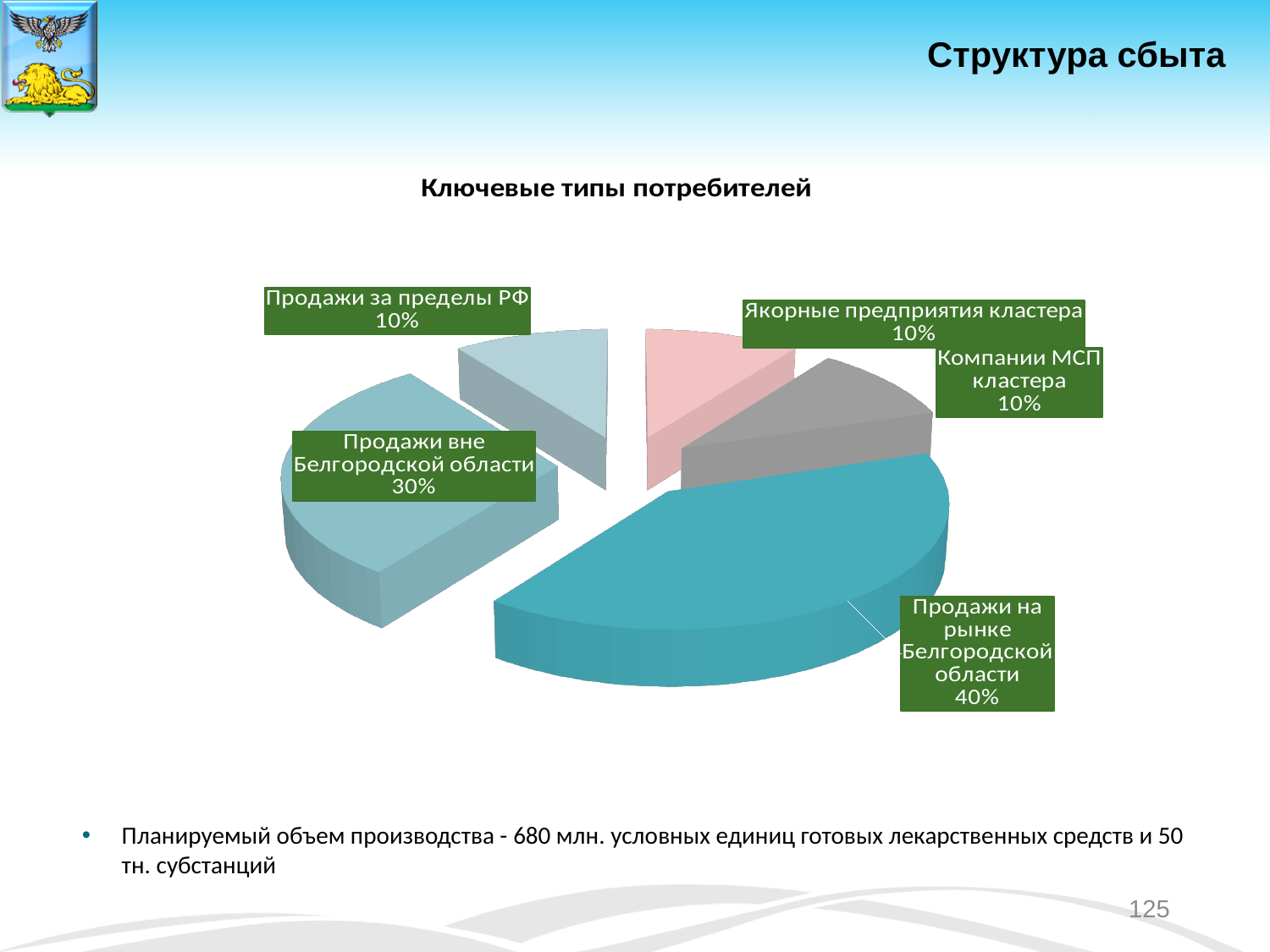
How many categories share the same value of 10%? 3 Which is larger: the share for "Продажи вне Белгородской области" or the share for "Продажи за пределы РФ"? Продажи вне Белгородской области What share of the pie does "Продажи за пределы РФ" represent? 10% What is the difference in percentage points between "Продажи на рынке Белгородской области" and "Продажи вне Белгородской области"? 10 percentage points What share of the pie does "Продажи на рынке Белгородской области" represent? 40% How many slices does the pie chart have? 5 Which category has the largest slice of the pie? Продажи на рынке Белгородской области What share of the pie does "Продажи вне Белгородской области" represent? 30% What share of the pie does "Компании МСП кластера" represent? 10% What share of the pie does "Якорные предприятия кластера" represent? 10% What kind of chart is shown on the slide? Pie chart What is the title of the chart? Ключевые типы потребителей